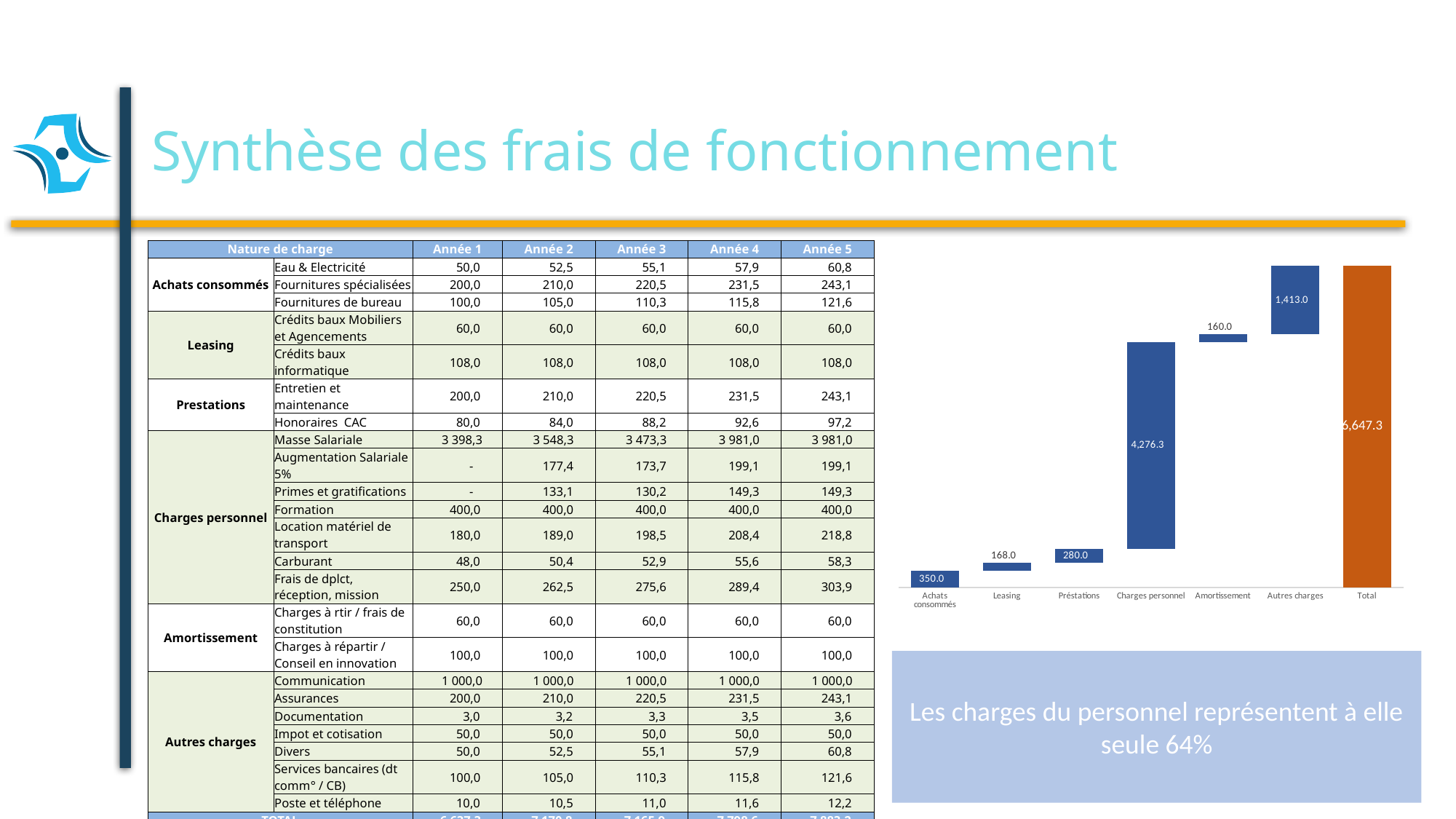
What is the difference between the values for Préstations and Amortissement in the chart? 120.0 How many bars are shown in the chart, including the Total bar? 7 Which category has the lowest value in the chart? Amortissement What is the value shown for Amortissement in the chart? 160.0 What is the difference between the values for Achats consommés and Leasing in the chart? 182.0 What is the value of the Total bar in the chart? 6,647.3 Excluding the Total bar, which category has the highest value in the chart? Charges personnel What is the value shown for Achats consommés in the chart? 350.0 Which is larger in the chart, Préstations or Leasing? Préstations What is the value shown for Autres charges in the chart? 1,413.0 What is the value shown for Charges personnel in the chart? 4,276.3 What kind of chart is shown on the slide? Bar chart